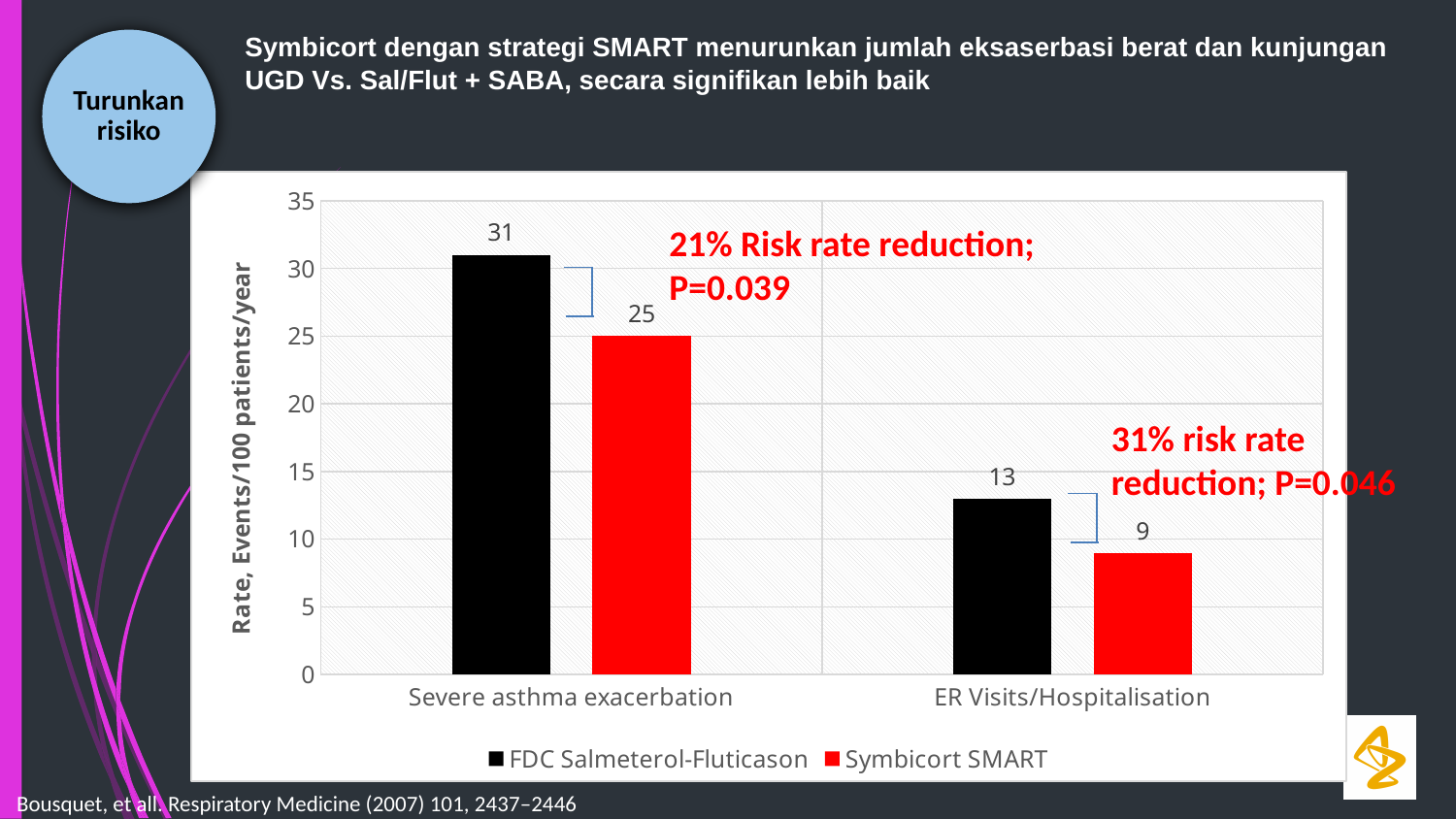
Which bar has the highest value on the chart? FDC Salmeterol-Fluticason, Severe asthma exacerbation Which bar has the lowest value on the chart? Symbicort SMART, ER Visits/Hospitalisation How many series does the legend list? 2 What is the value for Symbicort SMART in the ER Visits/Hospitalisation category? 9 Which series has the larger value for ER Visits/Hospitalisation? FDC Salmeterol-Fluticason How many categories are shown on the x axis? 2 What is the value for Symbicort SMART in the Severe asthma exacerbation category? 25 What type of chart is shown on the slide? Bar chart What is the difference between FDC Salmeterol-Fluticason and Symbicort SMART for Severe asthma exacerbation? 6 What is the difference between FDC Salmeterol-Fluticason and Symbicort SMART for ER Visits/Hospitalisation? 4 What is the value for FDC Salmeterol-Fluticason in the ER Visits/Hospitalisation category? 13 What is the value for FDC Salmeterol-Fluticason in the Severe asthma exacerbation category? 31